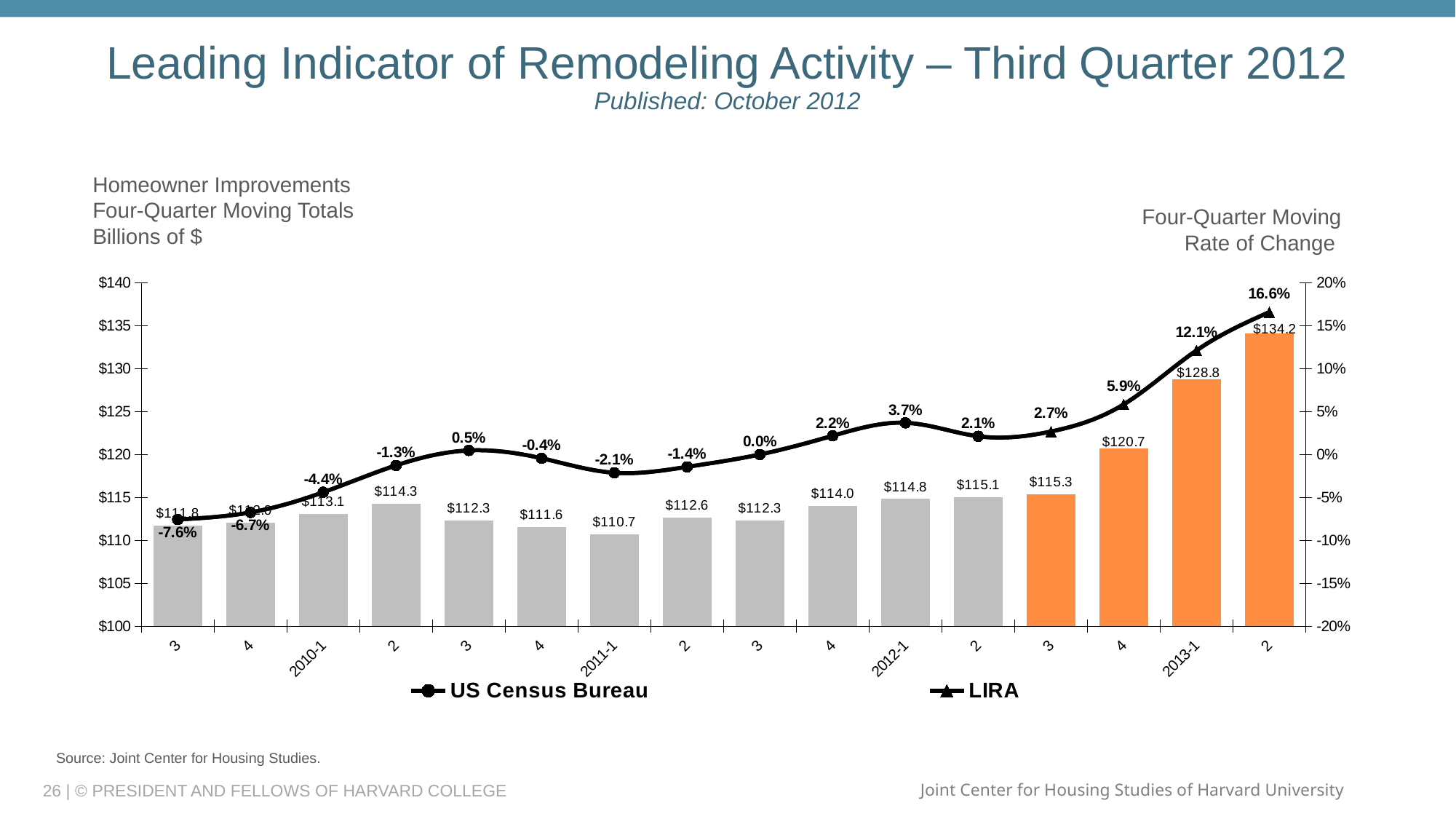
What is the rate of change shown for the last quarter on the chart (2013 quarter 2)? 16.6% How many bars are coloured orange? 4 How many bars are plotted on the chart? 16 Which quarter has the lowest four-quarter moving total? 2011-1 ($110.7) What kind of chart is this? Combination bar and line chart What is the four-quarter moving total for 2013-1? $128.8 What is the four-quarter moving rate of change shown for 2012-1? 3.7% What is the four-quarter moving total for 2011-1? $110.7 Which quarter has the highest four-quarter moving total? 2013 quarter 2 ($134.2) What is the difference between the four-quarter moving totals for 2013 quarter 2 and 2013-1? $5.4 Which is larger, the four-quarter moving total for 2010-1 or for 2012-1? 2012-1 ($114.8) How many series does the legend list? 2